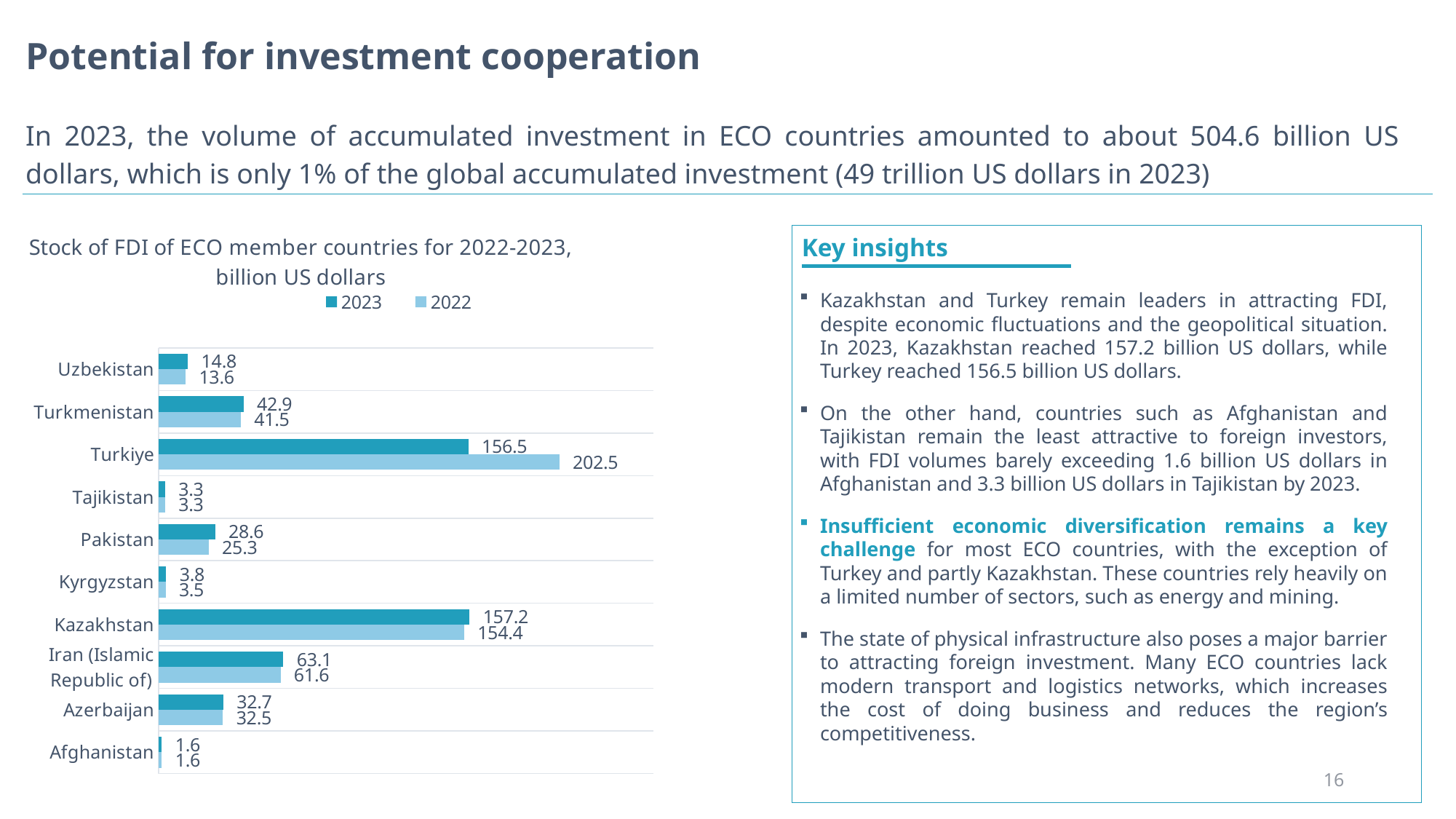
What is the title of the chart? Stock of FDI of ECO member countries for 2022-2023, billion US dollars What is the 2023 stock of FDI for Turkmenistan? 42.9 What is the 2022 stock of FDI for Turkiye? 202.5 How many series does the legend list? 2 What type of chart is shown on the slide? Bar chart What is the difference between Kazakhstan's 2023 and 2022 values? 2.8 Which country has the lowest 2022 stock of FDI? Afghanistan How many countries are shown in the chart? 10 Which country has the highest 2023 stock of FDI? Kazakhstan What is the difference between Turkiye's 2022 and 2023 values? 46.0 Which is larger for Pakistan, the 2023 value or the 2022 value? 2023 What is the 2023 value for Iran (Islamic Republic of)? 63.1